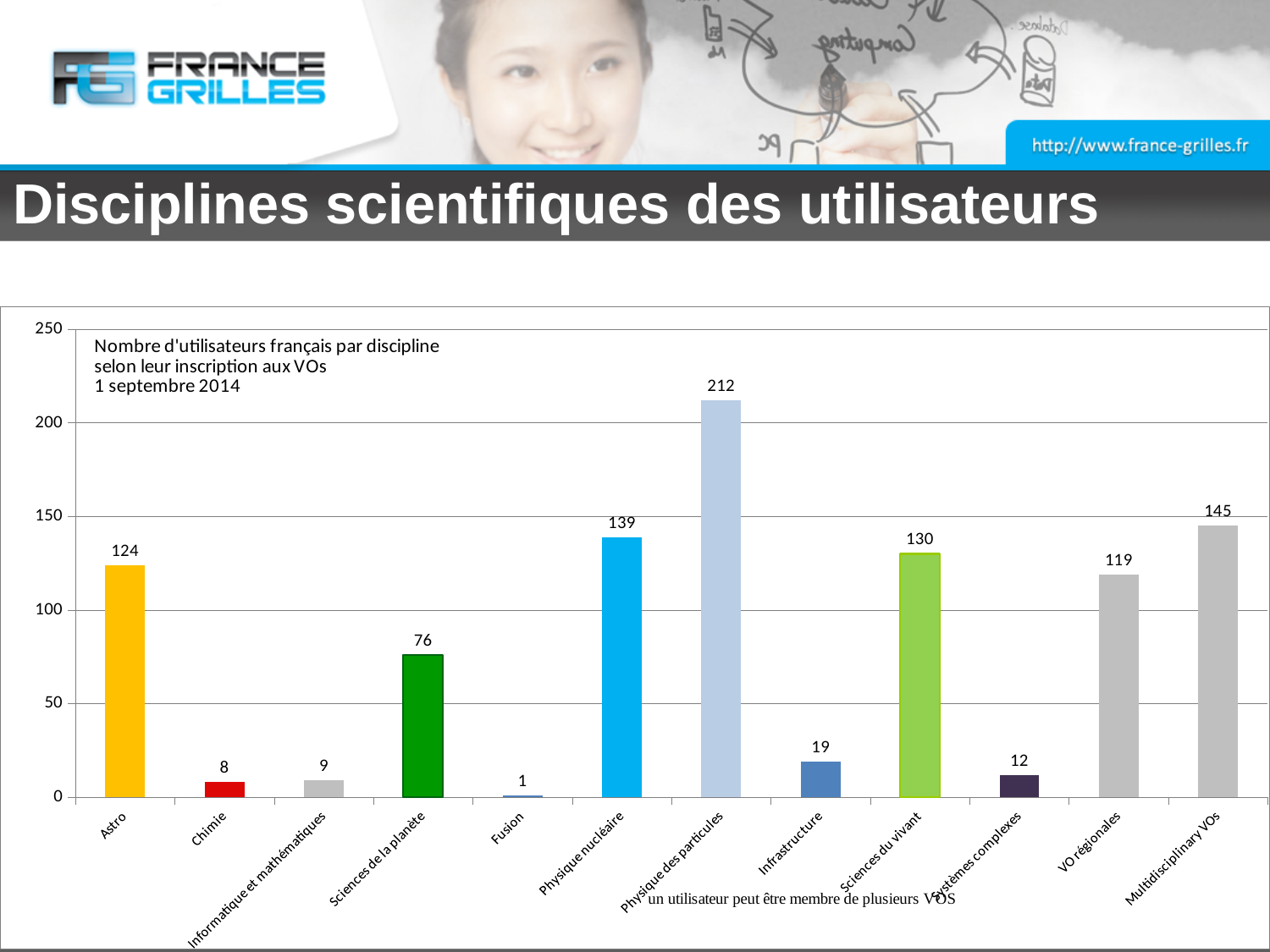
Which discipline has the lowest number of users? Fusion What date is given in the chart's title text? 1 septembre 2014 What is the value for Physique des particules? 212 How many disciplines are shown on the x axis? 12 What is the value for VO régionales? 119 Which discipline has the highest number of users? Physique des particules What is the difference between the values for Physique nucléaire and Sciences du vivant? 9 What is the value for Sciences de la planète? 76 Which is larger, the value for Astro or the value for VO régionales? Astro What kind of chart is shown on the slide? bar chart Is the value for Multidisciplinary VOs greater or less than 100? greater What is the difference between the values for Physique des particules and Multidisciplinary VOs? 67